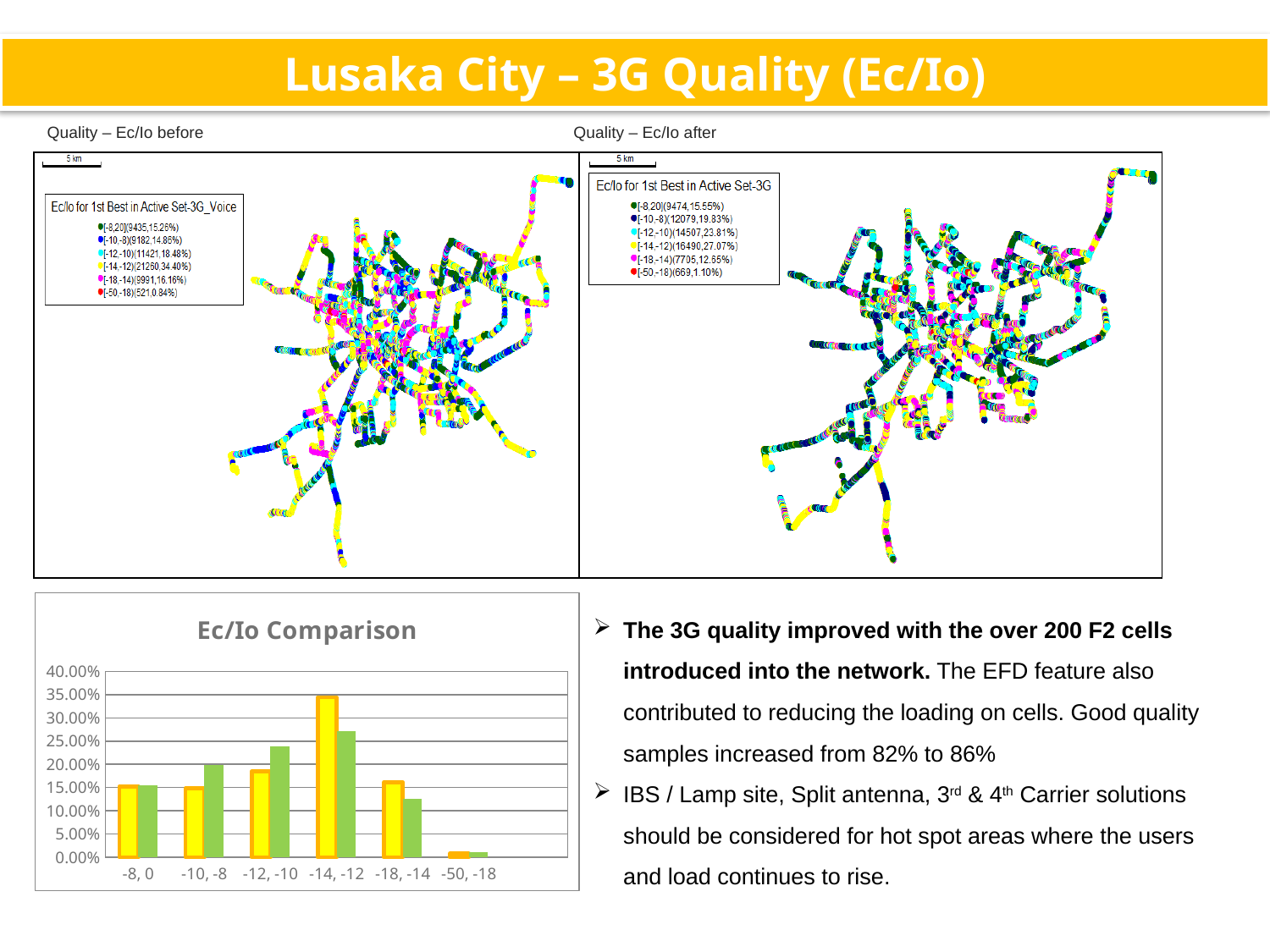
In the Ec/Io Comparison chart, which category has the shortest bars? -50, -18 In the Ec/Io Comparison chart, is the yellow bar for -14, -12 greater or less than 30.00%? greater How many categories are shown on the x axis of the Ec/Io Comparison chart? 6 In the Ec/Io Comparison chart, for the category -10, -8, which bar is taller, the yellow or the green? green In the Ec/Io Comparison chart, for the category -18, -14, which bar is taller, the yellow or the green? yellow In the Ec/Io Comparison chart, is the green bar for -14, -12 greater or less than 25.00%? greater What is the title of the bar chart at the bottom left of the slide? Ec/Io Comparison What is the highest value shown on the y axis of the Ec/Io Comparison chart? 40.00% In the Ec/Io Comparison chart, which category has the tallest yellow bar? -14, -12 In the Ec/Io Comparison chart, is the yellow bar for -50, -18 greater or less than 5.00%? less What kind of chart is the Ec/Io Comparison chart? bar chart